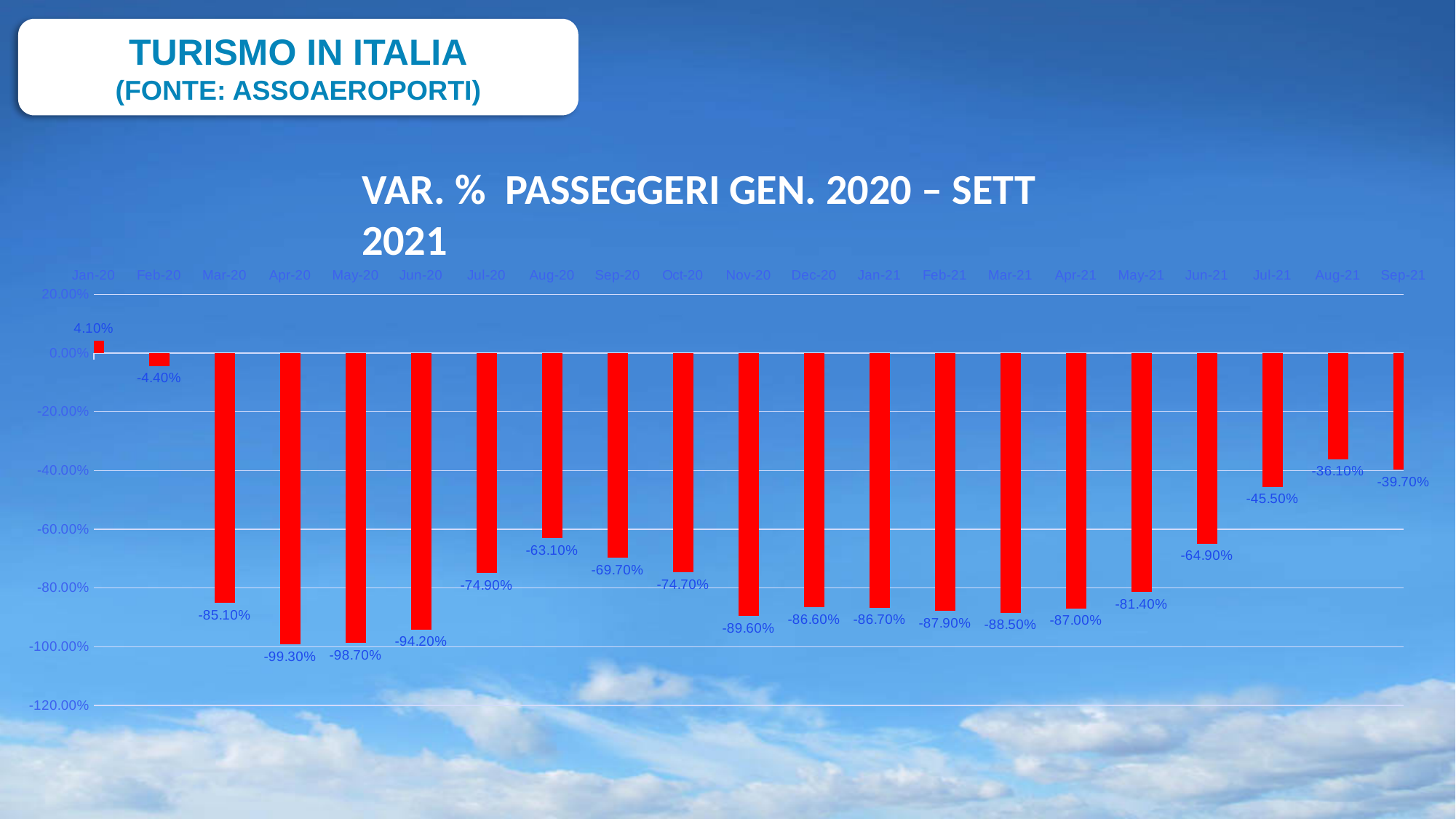
Which month has the lowest value? Apr-20 Do the values rise or fall from Jun-21 to Aug-21? Rise What is the title of the chart? VAR. % PASSEGGERI GEN. 2020 – SETT 2021 What is the value for Apr-20? -99.30% What is the difference between the values for Aug-21 and Sep-21? 3.60 percentage points How many months are plotted on the chart? 21 Which is larger, the value for Aug-20 or the value for Sep-20? Aug-20 What kind of chart is shown on the slide? Bar chart What is the value for Nov-20? -89.60% What is the value for Jan-20? 4.10% Which month has the highest value? Jan-20 What is the value for Aug-21? -36.10%